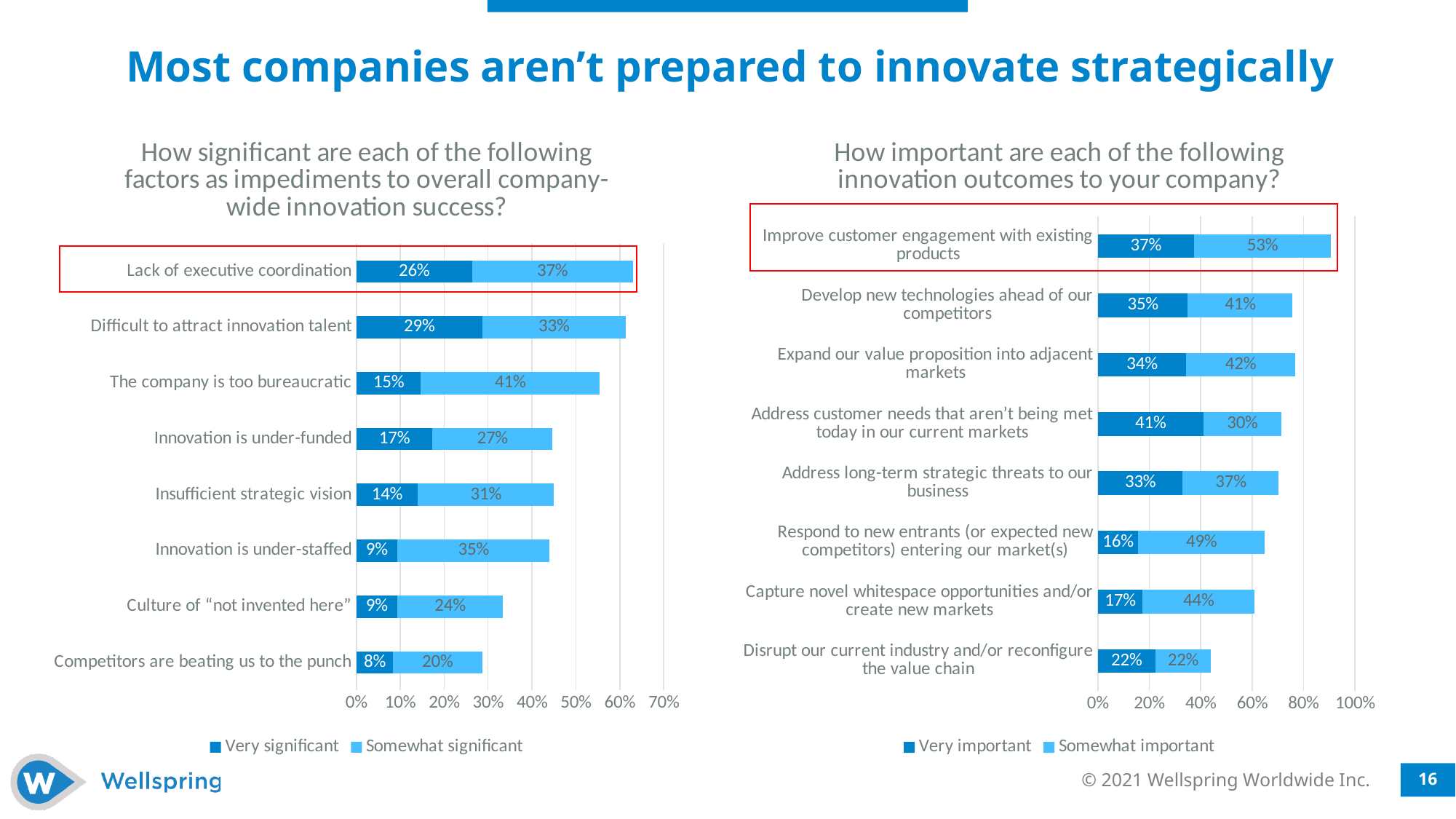
In the left chart (impediments to innovation success), what is the total of the stacked bar for 'Competitors are beating us to the punch'? 28% In the left chart (impediments to innovation success), which factor has the highest 'Very significant' value? Difficult to attract innovation talent What type of chart is the left chart (impediments to innovation success)? Stacked bar chart In the right chart (innovation outcomes), what is the 'Somewhat important' value for 'Improve customer engagement with existing products'? 53% In the left chart (impediments to innovation success), what is the difference between the 'Somewhat significant' values for 'Innovation is under-staffed' and 'Culture of "not invented here"'? 11% In the left chart (impediments to innovation success), what is the 'Very significant' value for 'Lack of executive coordination'? 26% In the left chart (impediments to innovation success), how many factors are listed? 8 How many series does the legend of the right chart (innovation outcomes) list? 2 In the left chart (impediments to innovation success), what is the 'Somewhat significant' value for 'The company is too bureaucratic'? 41% In the right chart (innovation outcomes), which is larger: the 'Very important' value for 'Develop new technologies ahead of our competitors' or for 'Disrupt our current industry and/or reconfigure the value chain'? Develop new technologies ahead of our competitors In the right chart (innovation outcomes), what is the total of the stacked bar for 'Improve customer engagement with existing products'? 90% In the right chart (innovation outcomes), which outcome has the highest 'Very important' value? Address customer needs that aren't being met today in our current markets